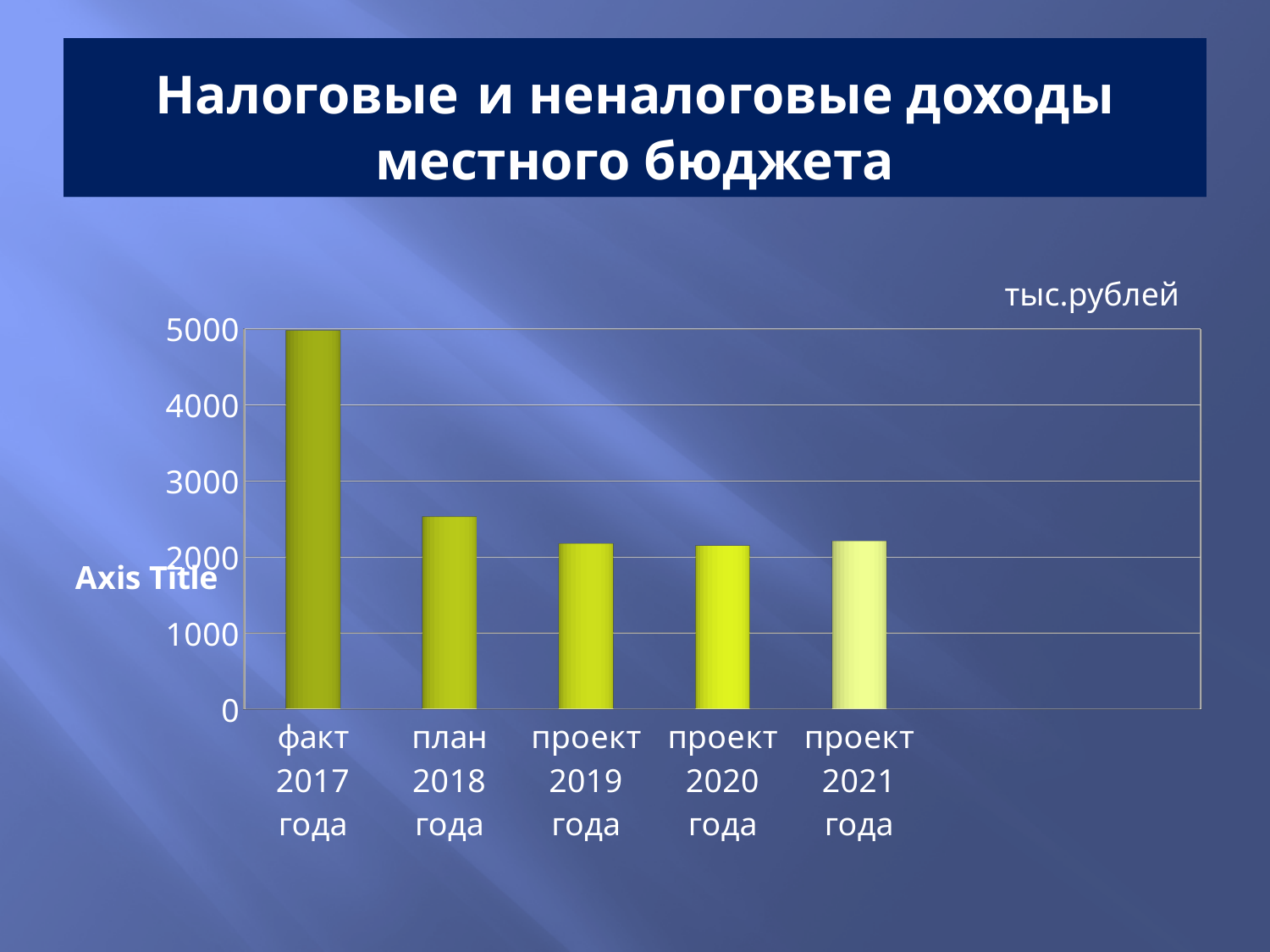
Is the value for факт 2017 года greater or less than 4000? greater Which is larger, the value for план 2018 года or the value for проект 2019 года? план 2018 года What kind of chart is shown on the slide? bar chart How many categories are shown on the x axis of the chart? 5 Is the value for план 2018 года greater or less than 2000? greater Is the value for план 2018 года greater or less than 3000? less What unit is indicated above the chart? тыс.рублей What is the title of the slide? Налоговые и неналоговые доходы местного бюджета Which is larger, the value for факт 2017 года or the value for план 2018 года? факт 2017 года Which category has the highest value in the chart? факт 2017 года